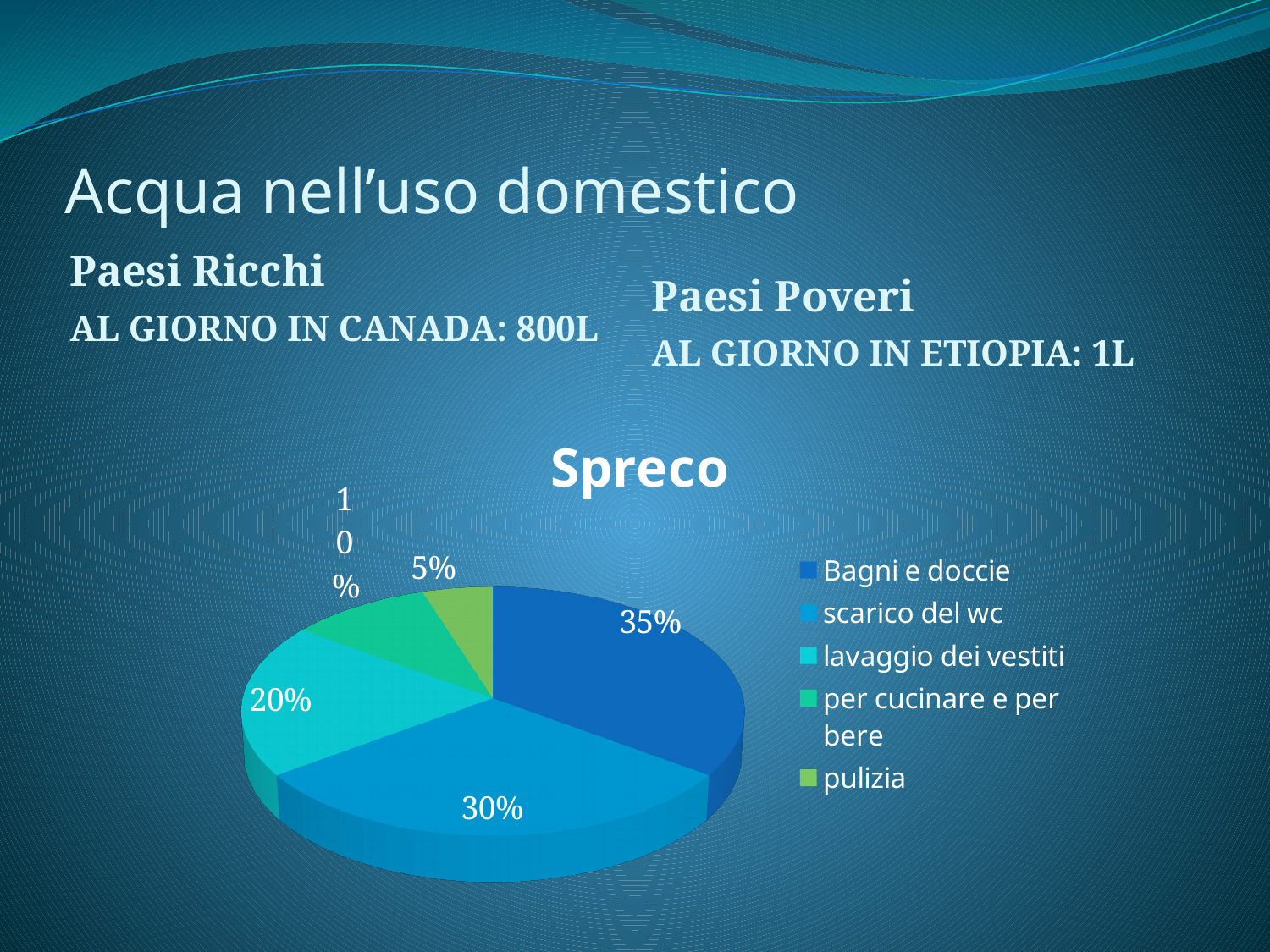
What is the title of the chart? Spreco What percentage of the pie is 'Bagni e doccie'? 35% What is the combined share of 'scarico del wc' and 'lavaggio dei vestiti'? 50% Which category has the largest share of the pie? Bagni e doccie Which category has the smallest share of the pie? pulizia What percentage of the pie is 'pulizia'? 5% What is the difference in percentage points between 'Bagni e doccie' and 'scarico del wc'? 5 Which is larger, the share for 'lavaggio dei vestiti' or the share for 'per cucinare e per bere'? lavaggio dei vestiti What percentage of the pie is 'lavaggio dei vestiti'? 20% How many categories does the pie chart have? 5 What percentage of the pie is 'scarico del wc'? 30% What kind of chart is shown on the slide? pie chart